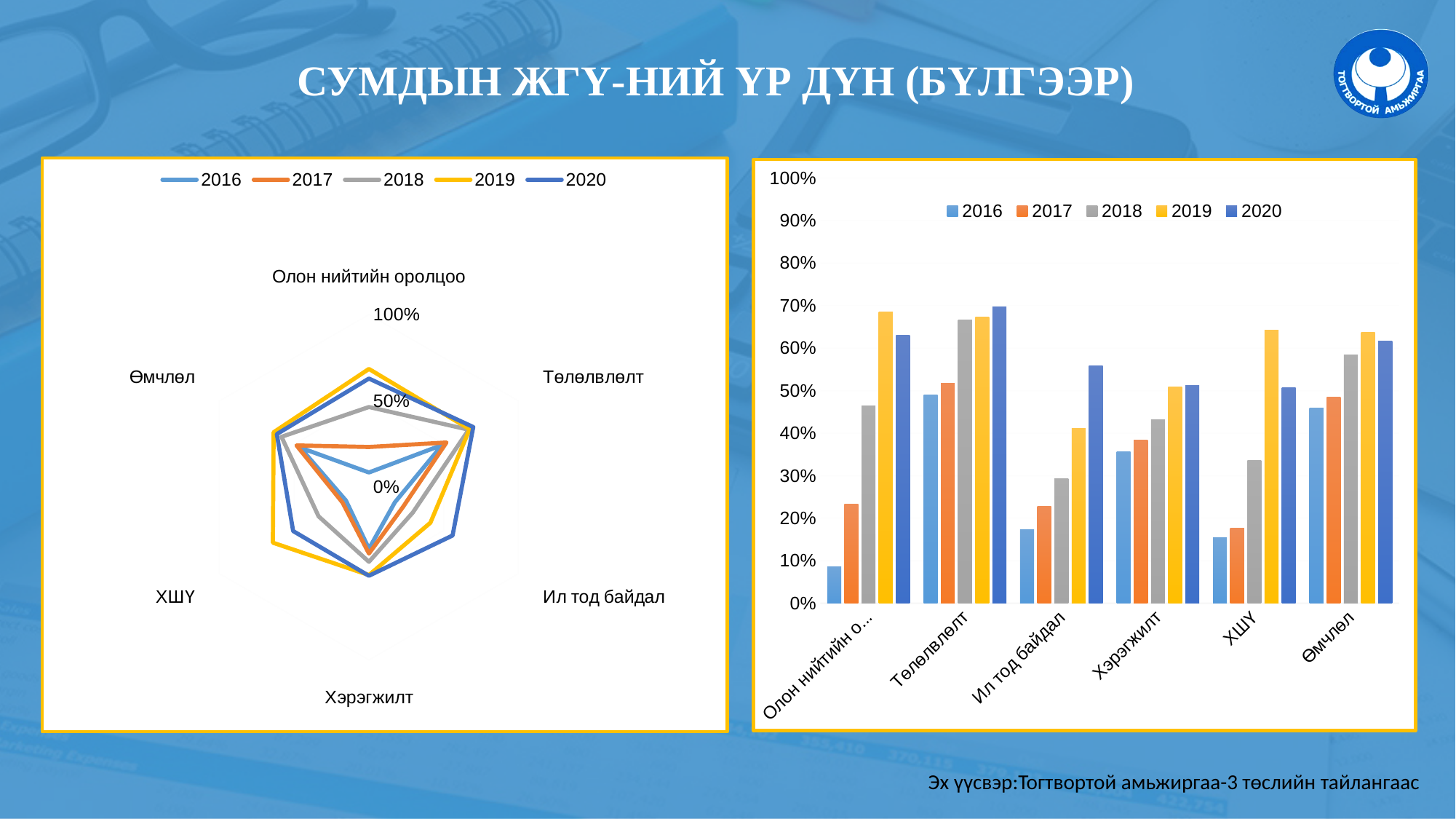
In the bar chart on the right, do the values for Ил тод байдал rise or fall from 2016 to 2020? rise In the bar chart on the right, which category has the lowest 2016 value? Олон нийтийн оролцоо In the bar chart on the right, which is larger for Ил тод байдал: the 2019 value or the 2020 value? 2020 In the bar chart on the right, is the 2016 value for Ил тод байдал greater or less than 20%? less What kind of chart is the chart on the right side of the slide? bar chart In the bar chart on the right, is the 2020 value for Ил тод байдал greater or less than 50%? greater In the bar chart on the right, how many series does the legend list? 5 What kind of chart is the chart on the left side of the slide? radar chart In the bar chart on the right, is the 2020 value for Төлөвлөлт greater or less than 60%? greater In the bar chart on the right, how many categories are shown on the x axis? 6 In the radar chart on the left, what are the legend entries? 2016, 2017, 2018, 2019, 2020 In the bar chart on the right, which is larger for ХШҮ: the 2019 value or the 2020 value? 2019